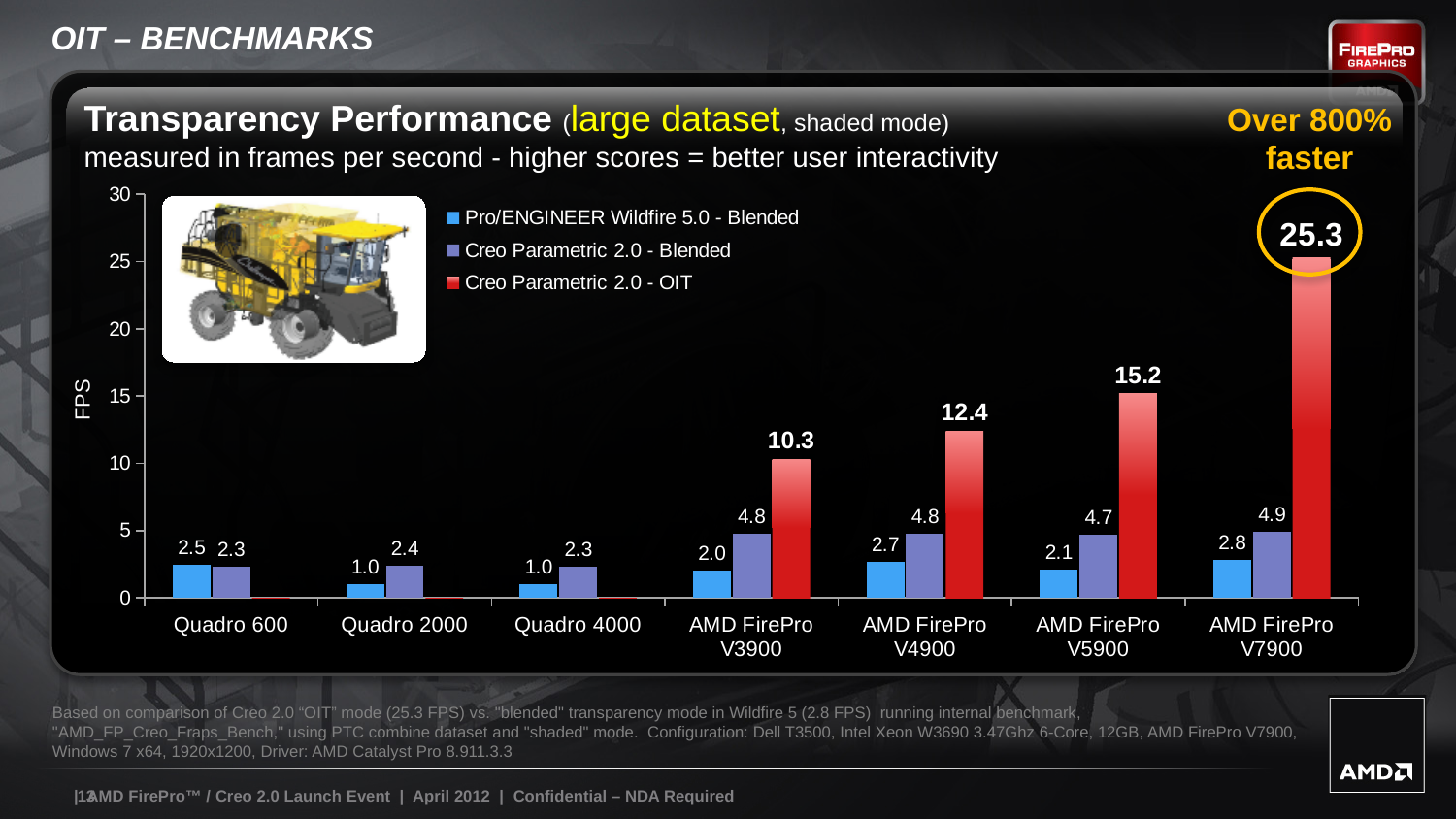
How many series does the legend list? 3 Which category has the highest Creo Parametric 2.0 - OIT value? AMD FirePro V7900 What is the label of the y axis? FPS What is the Pro/ENGINEER Wildfire 5.0 - Blended value for the Quadro 600? 2.5 What is the difference between the Creo Parametric 2.0 - OIT values for the AMD FirePro V7900 and the AMD FirePro V5900? 10.1 Is the Creo Parametric 2.0 - OIT value for the AMD FirePro V3900 greater or less than 10? greater How many categories are shown on the x axis? 7 What kind of chart is shown on the slide? bar chart What is the Creo Parametric 2.0 - OIT value for the AMD FirePro V7900? 25.3 Which category has the lowest Pro/ENGINEER Wildfire 5.0 - Blended value? Quadro 2000 and Quadro 4000 (1.0) What is the Creo Parametric 2.0 - Blended value for the AMD FirePro V5900? 4.7 Which is larger for the AMD FirePro V4900: the Creo Parametric 2.0 - OIT value or the Creo Parametric 2.0 - Blended value? Creo Parametric 2.0 - OIT